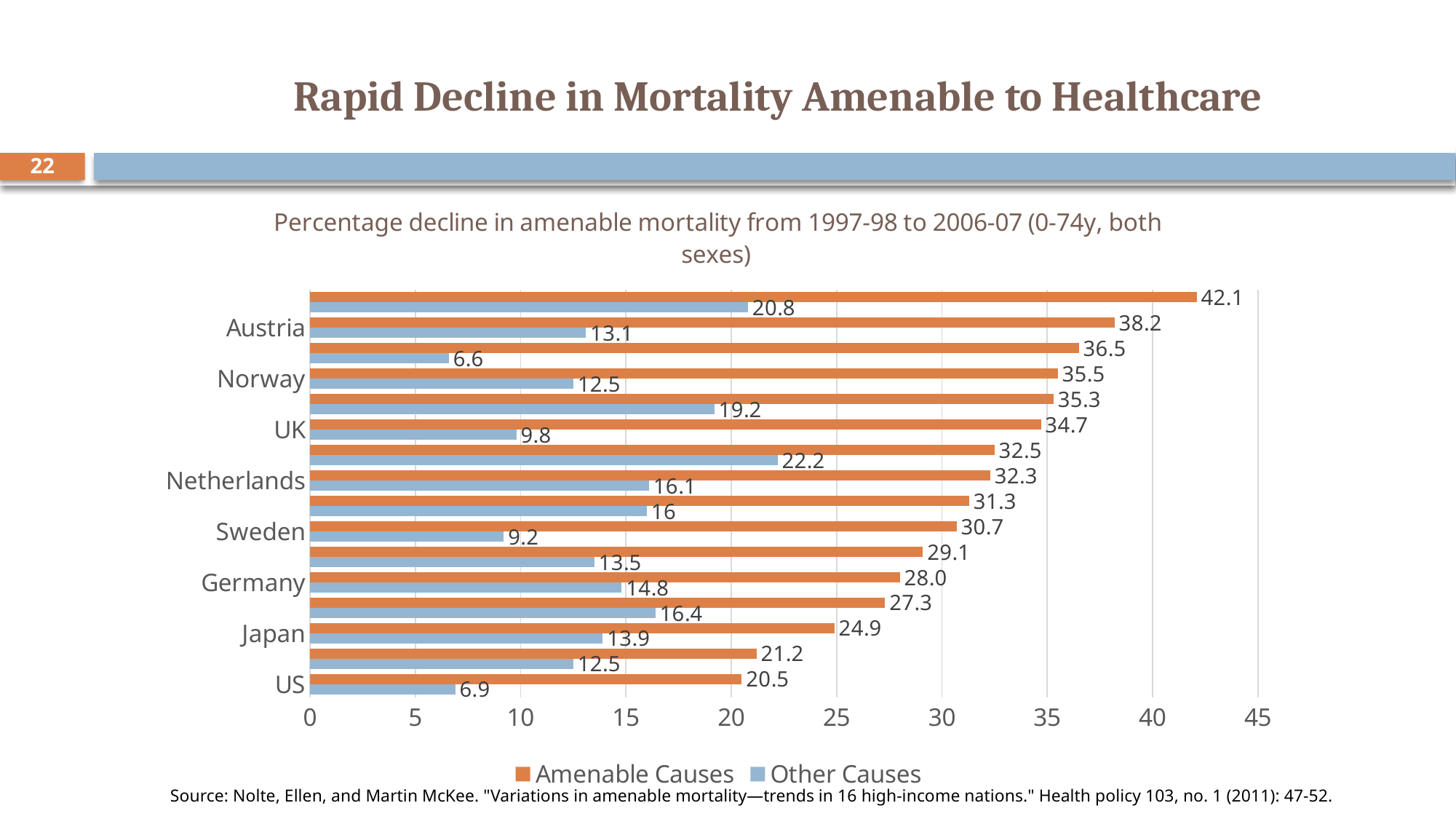
Which labeled country has the lowest Amenable Causes value? US What is the Amenable Causes value for the UK? 34.7 What is the largest Amenable Causes value shown on the chart? 42.1 What is the Other Causes value for Austria? 13.1 What is the Other Causes value for Sweden? 9.2 What is the Amenable Causes value for the US? 20.5 What is the Amenable Causes value for Japan? 24.9 How many series does the legend list? 2 What is the difference between the Amenable Causes and Other Causes values for Germany? 13.2 What kind of chart is shown on the slide? Bar chart Which is larger, the Other Causes value for Netherlands or for Norway? Netherlands What colour are the Amenable Causes bars? Orange